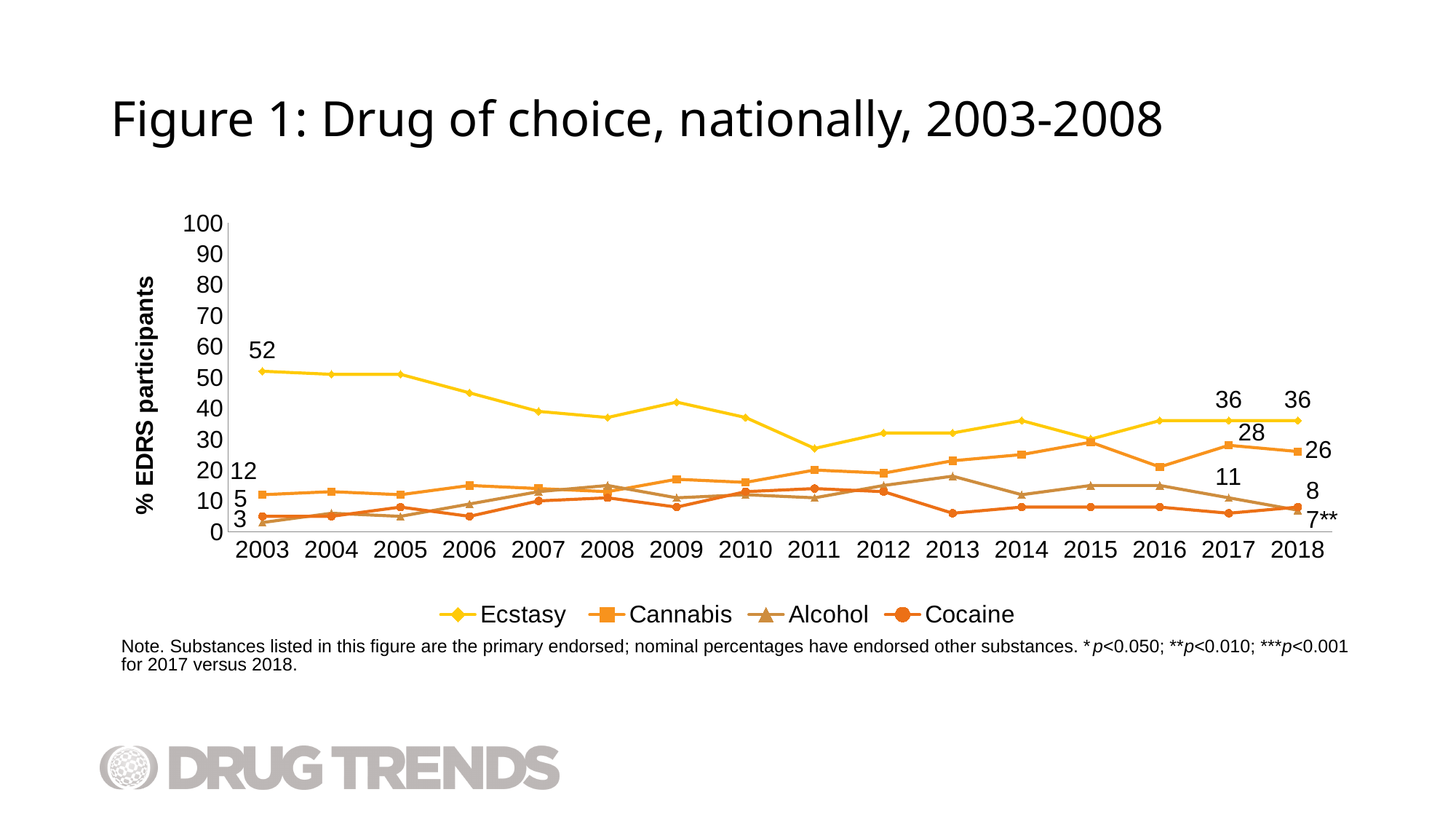
What is the value for Cannabis in 2017? 28 What is the difference between the Cannabis value in 2017 and in 2018? 2 What is the value for Cannabis in 2003? 12 What is the value for Ecstasy in 2003? 52 What is the difference between the Ecstasy value in 2003 and in 2018? 16 How many years are shown on the x axis? 16 What is the value for Alcohol in 2017? 11 How many series does the legend list? 4 Is the value for Ecstasy in 2006 greater or less than 40? greater What kind of chart is shown on the slide? Line chart Which is larger in 2018, the value for Ecstasy or the value for Cannabis? Ecstasy Which series has the highest value in 2003? Ecstasy